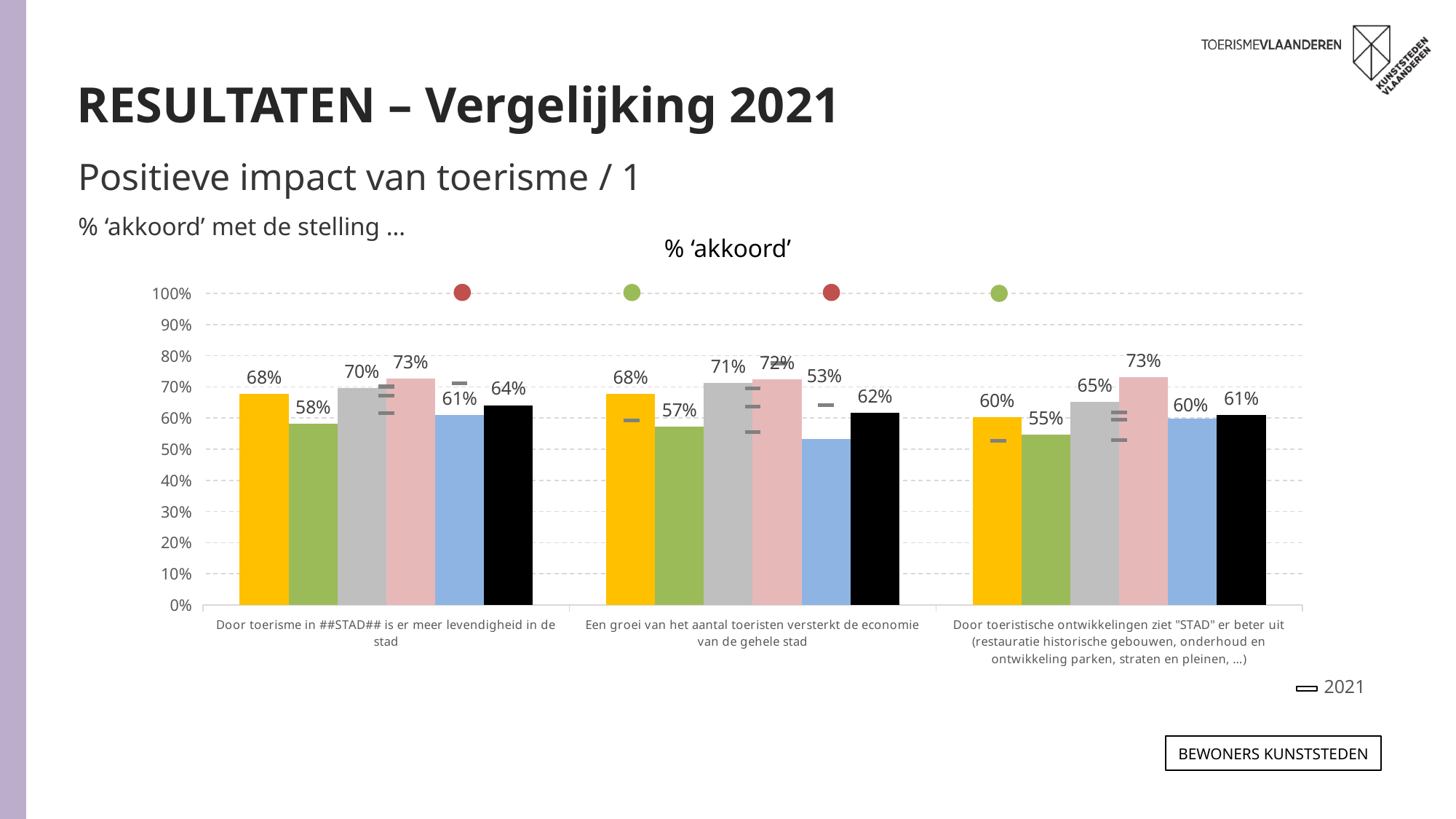
What is the value of the pink bar for "Een groei van het aantal toeristen versterkt de economie van de gehele stad"? 72% What is the value of the yellow bar for "Door toerisme in ##STAD## is er meer levendigheid in de stad"? 68% What is the value of the black bar for "Door toeristische ontwikkelingen ziet "STAD" er beter uit"? 61% What is the value of the blue bar for "Een groei van het aantal toeristen versterkt de economie van de gehele stad"? 53% What is the difference between the pink bar and the green bar for "Door toeristische ontwikkelingen ziet "STAD" er beter uit"? 18 percentage points What kind of chart is shown on the slide? Bar chart Which coloured bar is the highest for "Door toerisme in ##STAD## is er meer levendigheid in de stad"? The pink bar (73%) Which coloured bar is the lowest for "Een groei van het aantal toeristen versterkt de economie van de gehele stad"? The blue bar (53%) What is the title of the chart? % 'akkoord' How many statement categories are shown on the x axis? 3 Which is larger for "Door toerisme in ##STAD## is er meer levendigheid in de stad": the grey bar or the black bar? The grey bar (70%) How many bars are shown for each statement? 6